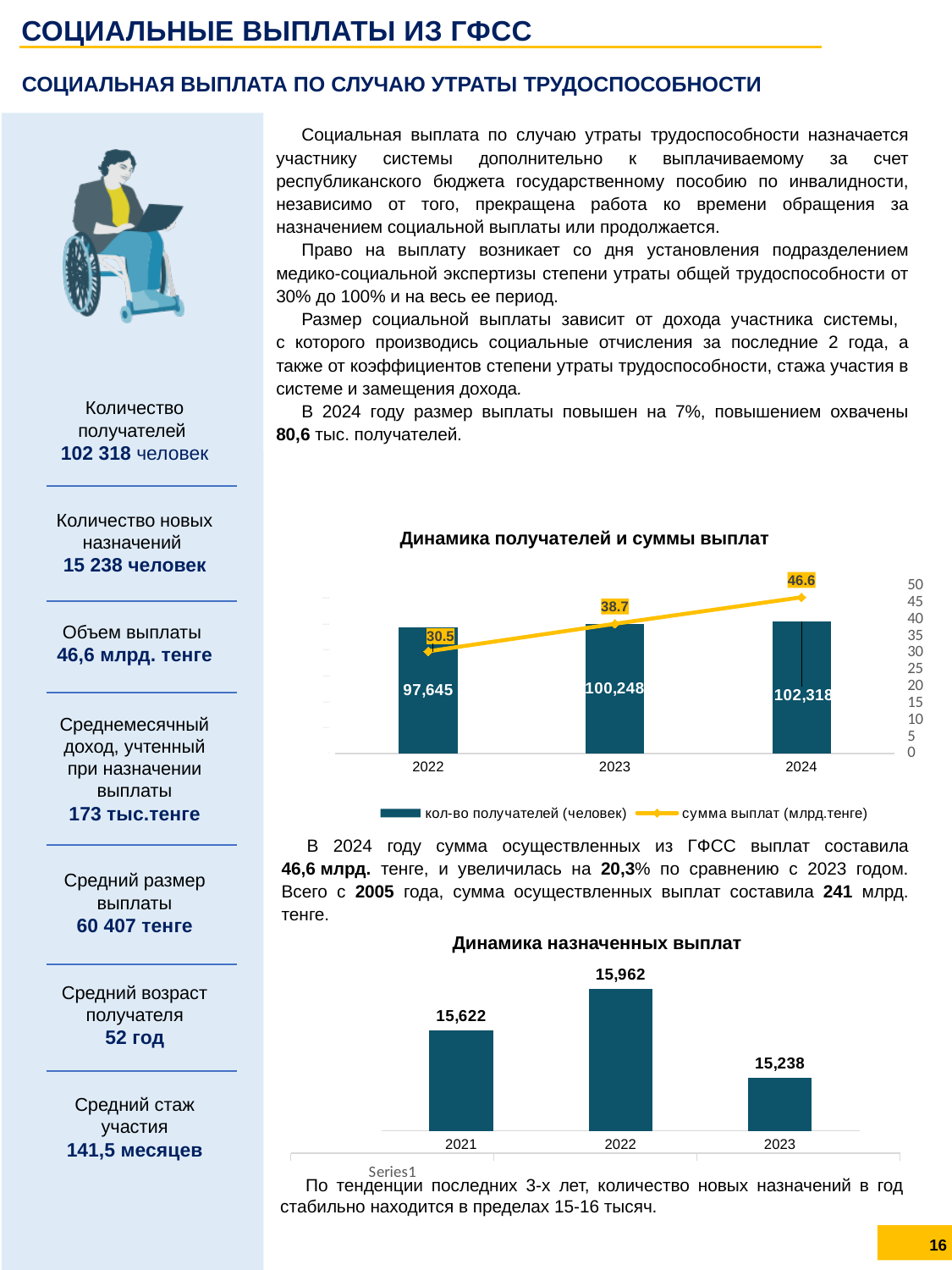
In the chart 'Динамика получателей и суммы выплат', does the сумма выплат line rise or fall from 2022 to 2024? rise In the chart 'Динамика получателей и суммы выплат', what is the number of recipients (кол-во получателей) in 2023? 100,248 In the chart 'Динамика получателей и суммы выплат', by how much did the number of recipients increase from 2022 to 2024? 4,673 In the chart 'Динамика назначенных выплат', what is the difference between the 2022 and 2023 values? 724 In the chart 'Динамика назначенных выплат', what is the value for 2022? 15,962 In the chart 'Динамика получателей и суммы выплат', how many series does the legend list? 2 In the chart 'Динамика получателей и суммы выплат', what is the difference in сумма выплат between 2023 and 2022? 8.2 In the chart 'Динамика получателей и суммы выплат', which year has the lowest сумма выплат value? 2022 In the chart 'Динамика назначенных выплат', how many years are shown on the x axis? 3 What type of chart is 'Динамика назначенных выплат'? bar chart In the chart 'Динамика получателей и суммы выплат', what is the сумма выплат (млрд.тенге) value for 2024? 46.6 In the chart 'Динамика назначенных выплат', which year has the lowest value? 2023